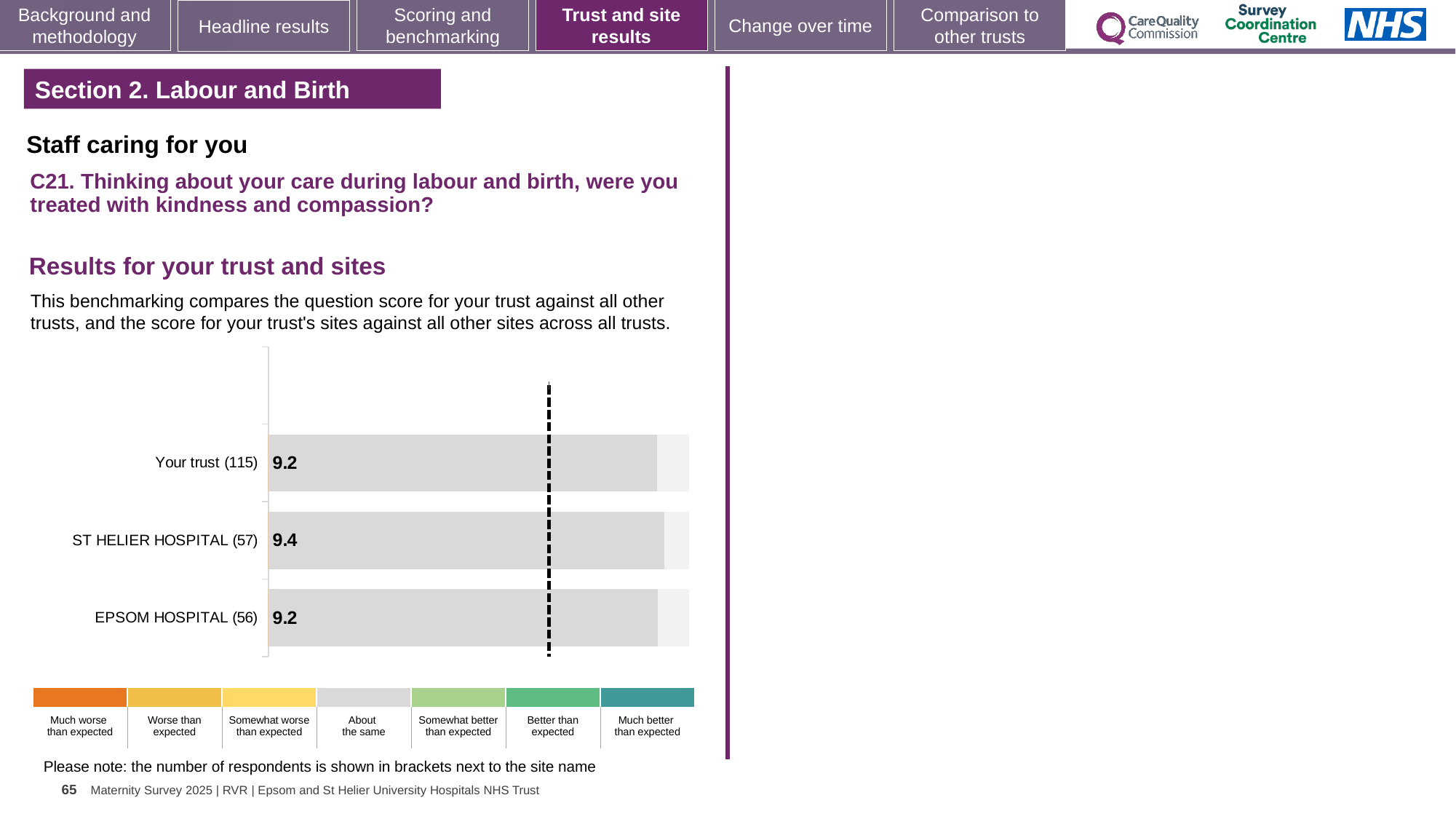
How many respondents are shown in brackets for EPSOM HOSPITAL? 56 What is the score for ST HELIER HOSPITAL? 9.4 What is the score for EPSOM HOSPITAL? 9.2 What is the score for Your trust? 9.2 What kind of chart is shown on the slide? Bar chart Do the scores for Your trust and EPSOM HOSPITAL have the same value? Yes Which site or trust has the highest score? ST HELIER HOSPITAL How many bars are plotted in the chart? 3 What is the difference between the scores for ST HELIER HOSPITAL and EPSOM HOSPITAL? 0.2 Which has the larger score, ST HELIER HOSPITAL or Your trust? ST HELIER HOSPITAL How many respondents are shown in brackets for Your trust? 115